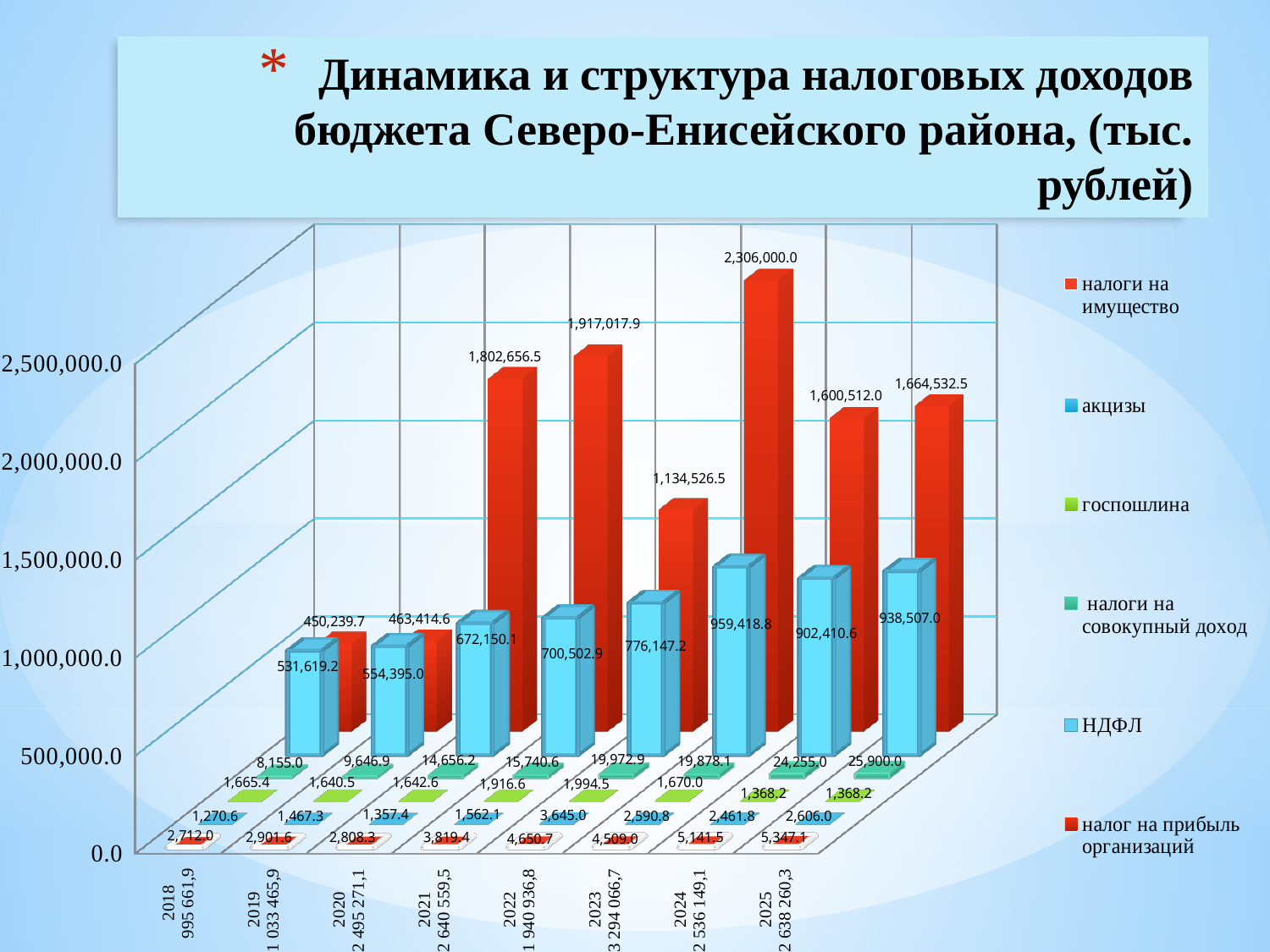
What is the value of НДФЛ for 2025? 938,507.0 In which year is НДФЛ highest? 2023 In which year is налоги на имущество lowest? 2018 Does НДФЛ rise or fall from 2018 to 2023? rise What is the value of налоги на совокупный доход for 2025? 25,900.0 What is the value of налог на прибыль организаций for 2022? 1,134,526.5 By how much did НДФЛ increase from 2018 to 2019? 22,775.8 What kind of chart is shown on the slide? bar chart Which year has the larger value for налоги на имущество, 2020 or 2021? 2021 How many years are shown along the x axis? 8 How many series does the legend list? 6 What is the value of налоги на имущество for 2023? 4,509.0